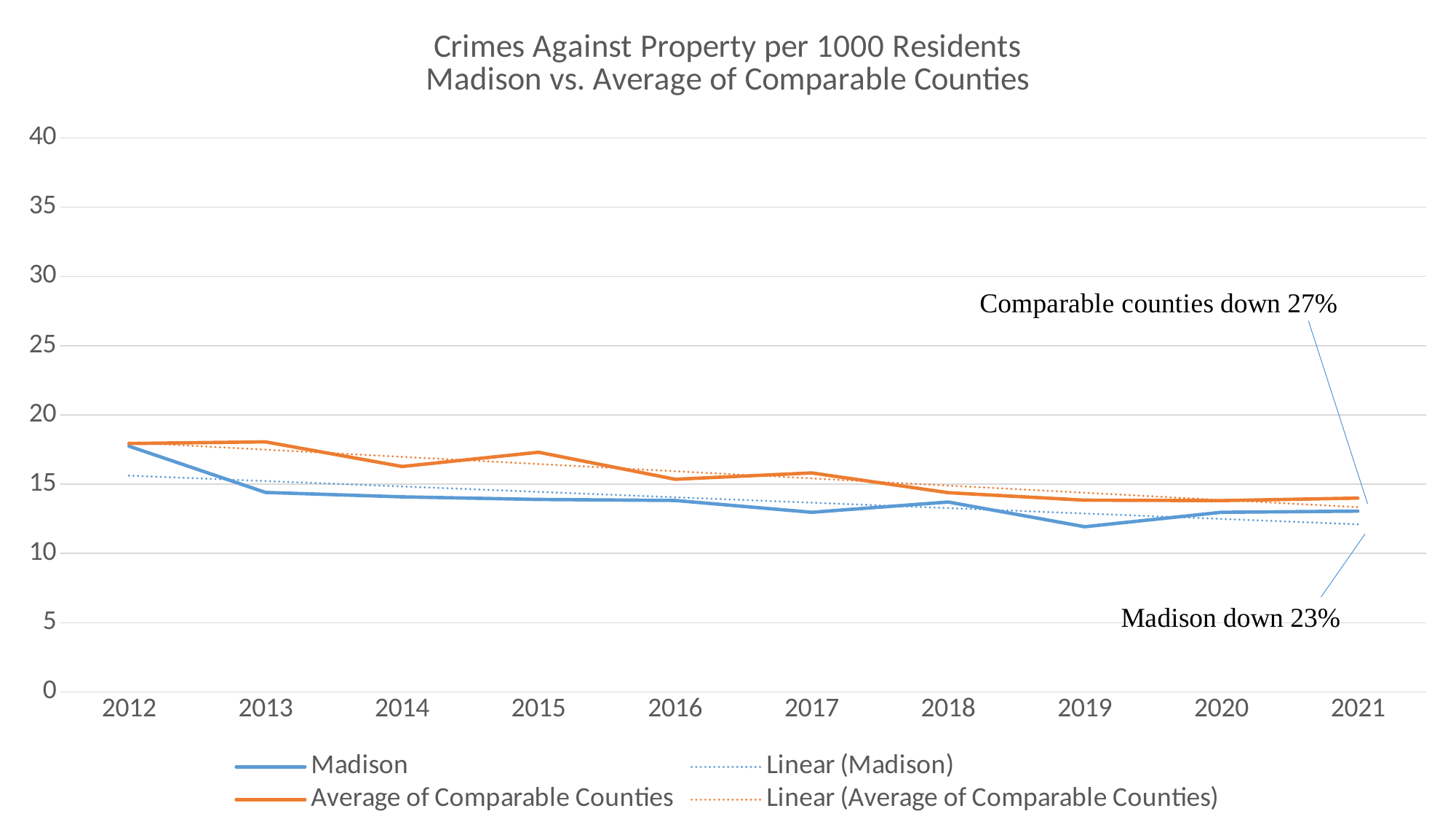
What kind of chart is shown on the slide? line chart In which year is the Madison value lowest? 2019 Is the Madison value for 2012 greater or less than 15? greater According to the annotation, by what percentage did comparable counties decline? 27% How many entries does the legend list? 4 How many years are plotted along the x axis? 10 Is the Madison value for 2019 greater or less than 15? less Is the Average of Comparable Counties value for 2015 greater or less than 15? greater According to the annotation, by what percentage did Madison decline? 23% Do the Average of Comparable Counties values generally rise or fall from 2012 to 2021? fall In 2015, which is larger: Madison or Average of Comparable Counties? Average of Comparable Counties In which year is the Madison value highest? 2012